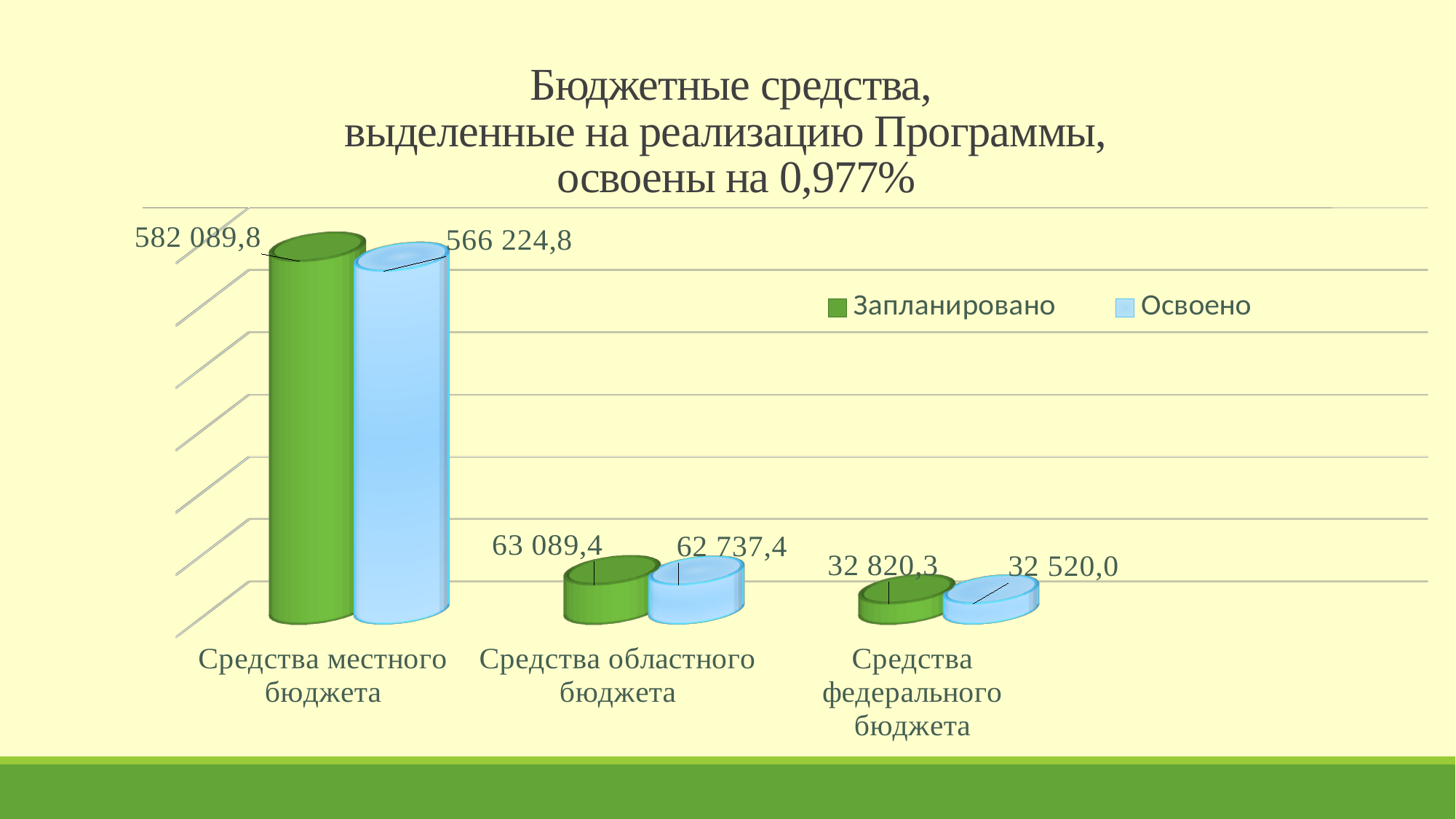
What is the Освоено value for Средства федерального бюджета? 32 520,0 What kind of chart is shown on the slide? Bar chart How many series does the legend list? 2 What is the Запланировано value for Средства областного бюджета? 63 089,4 Which is larger for Средства федерального бюджета: the Запланировано value or the Освоено value? Запланировано What is the Запланировано value for Средства местного бюджета? 582 089,8 How many categories are shown on the x axis? 3 What is the difference between the Запланировано and Освоено values for Средства областного бюджета? 352,0 What is the Освоено value for Средства местного бюджета? 566 224,8 What is the difference between the Запланировано and Освоено values for Средства местного бюджета? 15 865,0 Which category has the highest Запланировано value? Средства местного бюджета Which category has the lowest Освоено value? Средства федерального бюджета